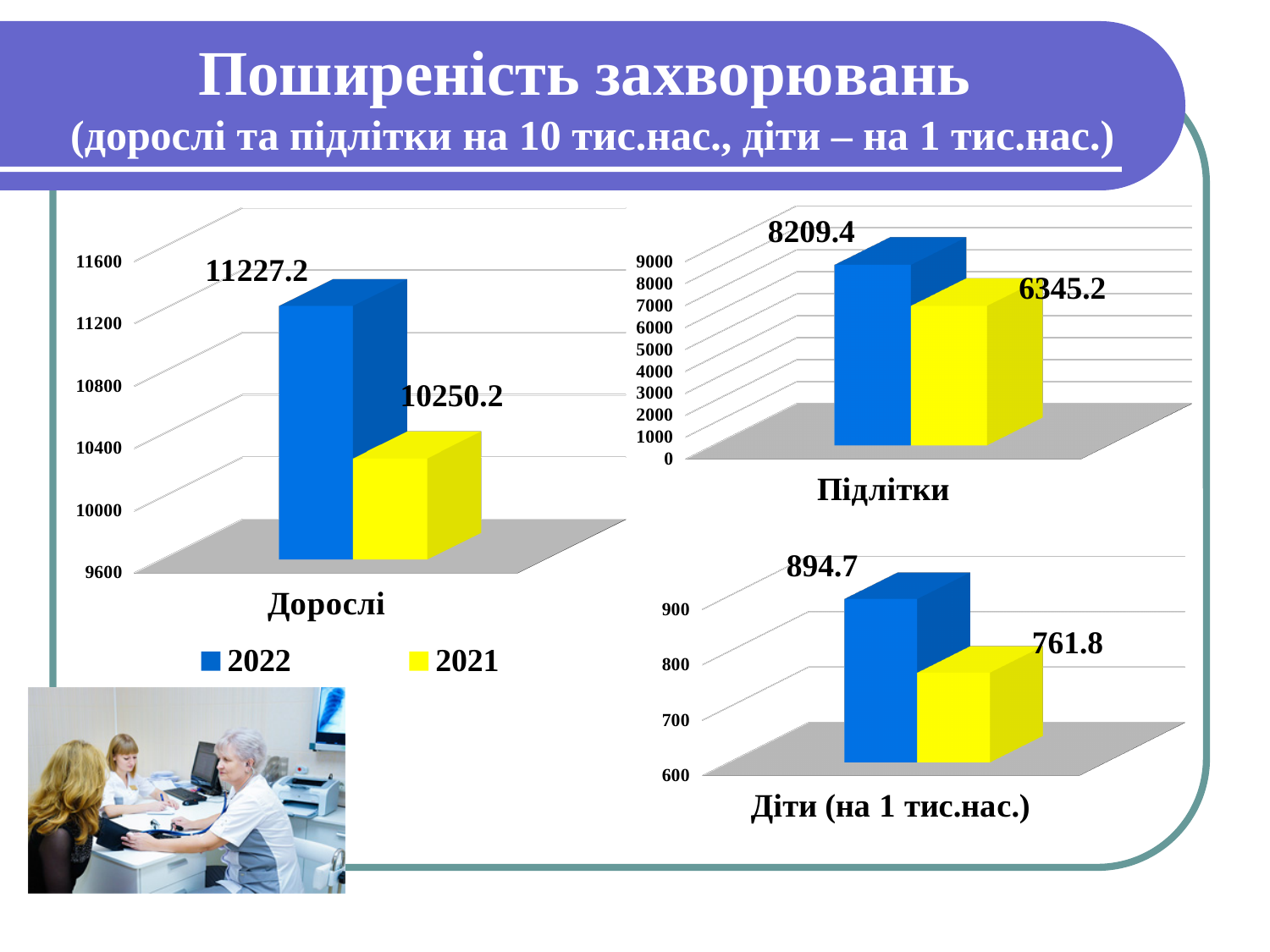
In the "Дорослі" chart, what is the difference between the 2022 and 2021 values? 977 In the "Підлітки" chart, what is the value for 2021? 6345.2 In the "Діти (на 1 тис.нас.)" chart, what is the value for 2022? 894.7 In the "Підлітки" chart, what is the value for 2022? 8209.4 In the "Підлітки" chart, which year has the lowest value? 2021 What kind of chart is the "Дорослі" chart? Bar chart In the "Дорослі" chart, what is the value for 2022? 11227.2 How many series does the legend under the "Дорослі" chart list? 2 In the "Діти (на 1 тис.нас.)" chart, which year has the larger value, 2022 or 2021? 2022 In the "Діти (на 1 тис.нас.)" chart, what is the value for 2021? 761.8 In the "Дорослі" chart, what is the value for 2021? 10250.2 In the "Підлітки" chart, what is the difference between the 2022 and 2021 values? 1864.2